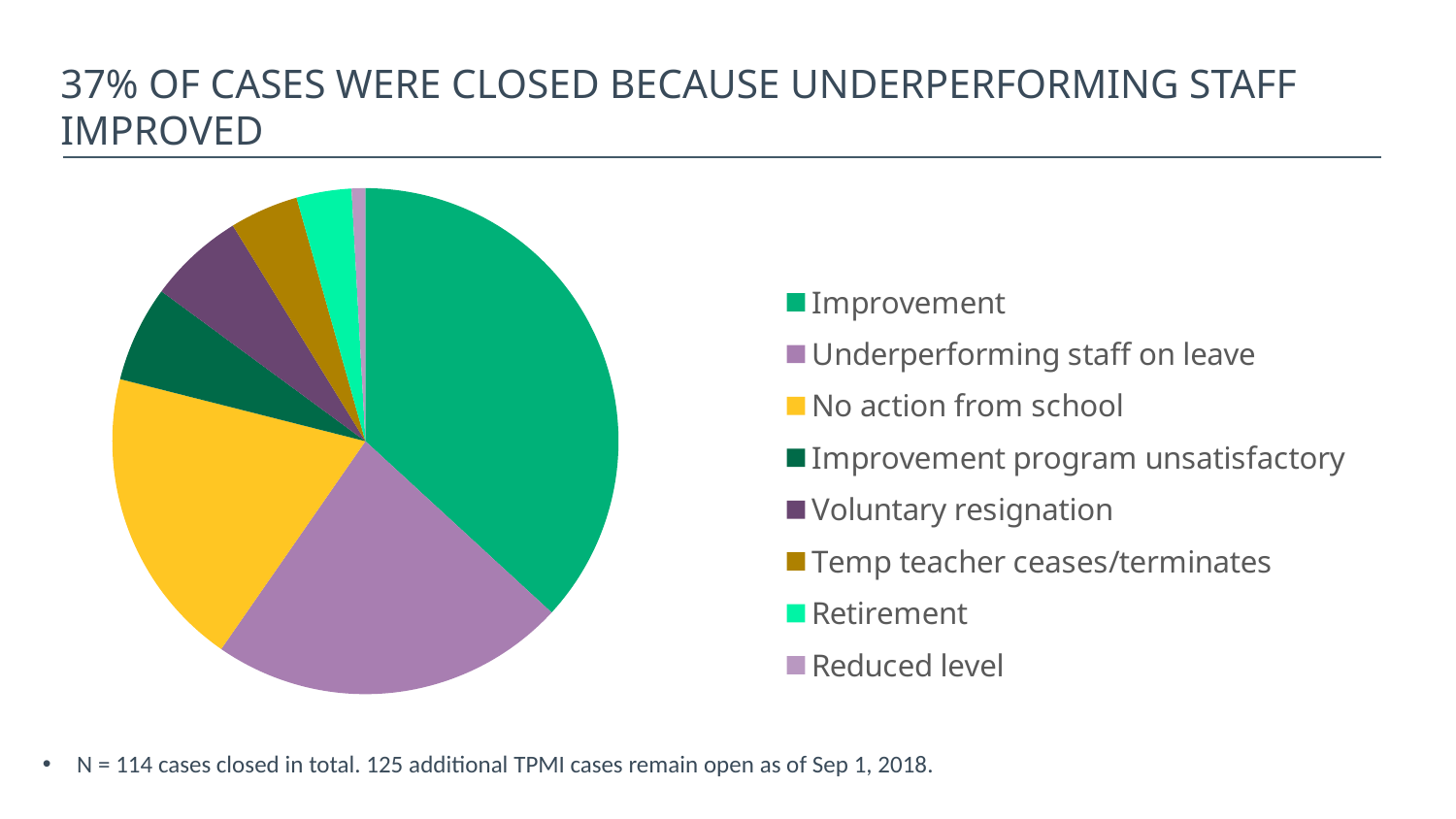
What kind of chart is shown on the slide? pie chart Which slice is larger: Improvement or Underperforming staff on leave? Improvement Which category has the largest slice of the pie chart? Improvement How many categories does the pie chart's legend list? 8 Which slice is larger: No action from school or Voluntary resignation? No action from school Which slice is larger: Improvement program unsatisfactory or Retirement? Improvement program unsatisfactory Which category is shown in yellow in the pie chart? No action from school What share of closed cases does the Improvement slice represent? 37% According to the note below the chart, how many cases were closed in total? 114 What is the title of the slide containing the pie chart? 37% of cases were closed because underperforming staff improved Which category has the smallest slice of the pie chart? Reduced level